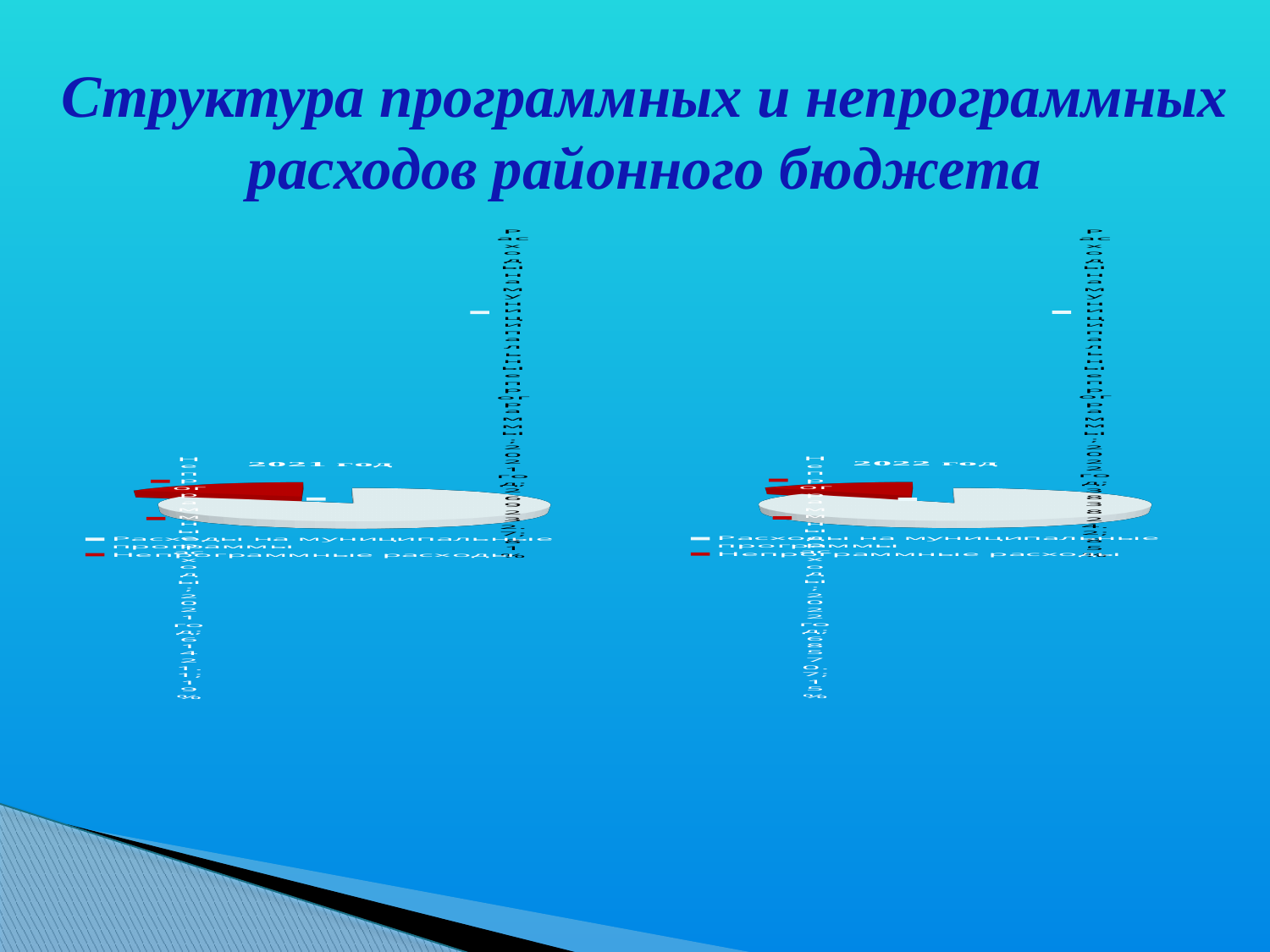
What kind of chart is the right chart titled "2022 год"? pie chart In the left chart (2021 год), which category has the largest slice? Расходы на муниципальные программы How many charts are shown on the slide? 2 In the left chart (2021 год), how many entries does the legend list? 2 In the left chart (2021 год), which category has the larger slice: Расходы на муниципальные программы or Непрограммные расходы? Расходы на муниципальные программы In the right chart (2022 год), which category has the smallest slice? Непрограммные расходы In the right chart (2022 год), which category has the larger slice: Расходы на муниципальные программы or Непрограммные расходы? Расходы на муниципальные программы What kind of chart is the left chart titled "2021 год"? pie chart In the left chart (2021 год), how many slices does the pie have? 2 In the right chart (2022 год), how many entries does the legend list? 2 What is the title of the left chart? 2021 год In the right chart (2022 год), what colour is the slice for Непрограммные расходы? red